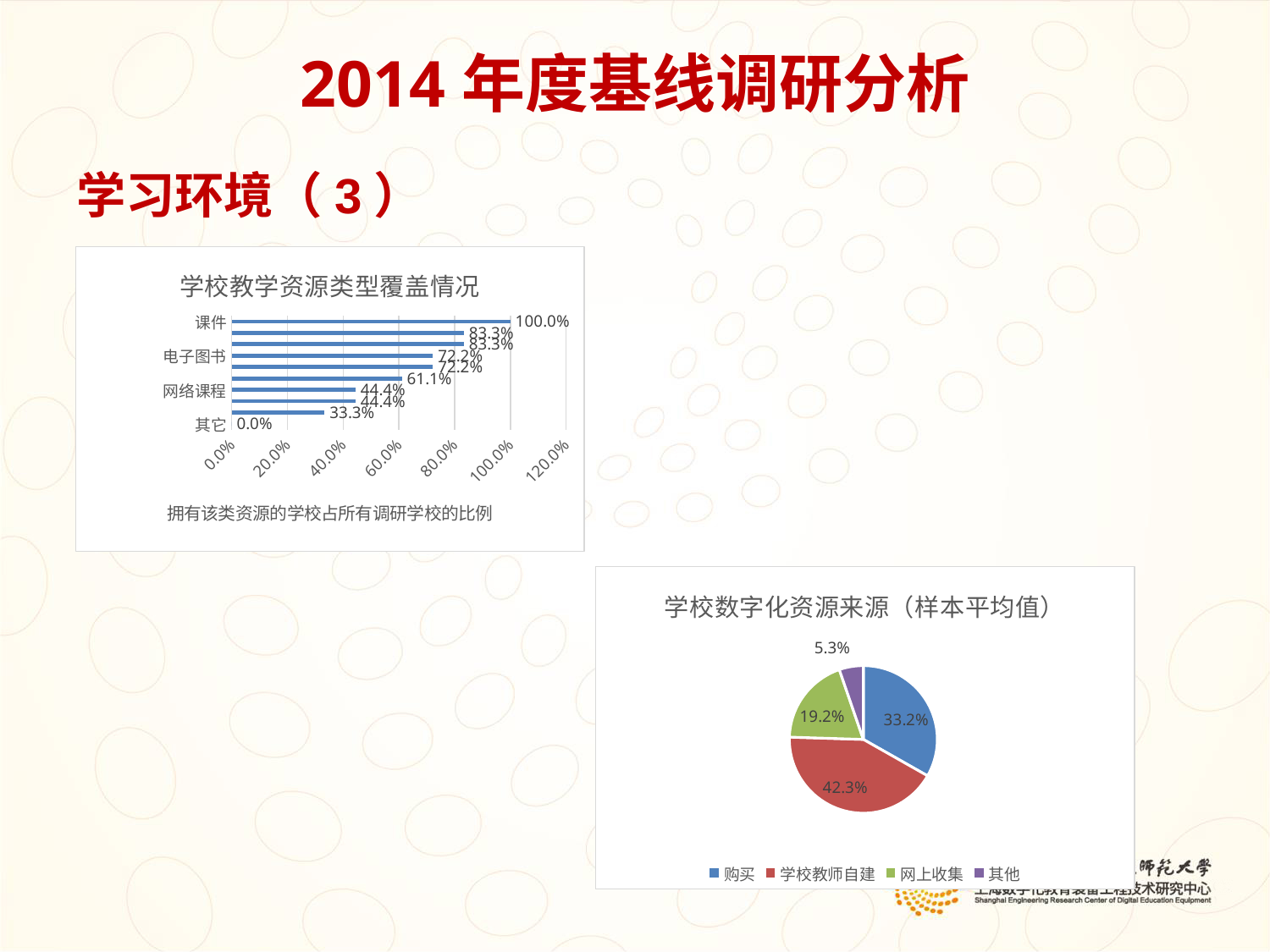
In the chart titled 学校教学资源类型覆盖情况, what is the difference between the values for 课件 and 电子图书? 27.8% In the chart titled 学校教学资源类型覆盖情况, what kind of chart is shown? Bar chart In the pie chart titled 学校数字化资源来源（样本平均值）, how many entries does the legend list? 4 In the pie chart titled 学校数字化资源来源（样本平均值）, what is the share for 学校教师自建? 42.3% In the pie chart titled 学校数字化资源来源（样本平均值）, what is the share for 购买? 33.2% In the chart titled 学校教学资源类型覆盖情况, what is the value for 其它? 0.0% In the pie chart titled 学校数字化资源来源（样本平均值）, which is larger, 网上收集 or 其他? 网上收集 In the chart titled 学校教学资源类型覆盖情况, what is the value for 电子图书? 72.2% In the chart titled 学校教学资源类型覆盖情况, which category has the highest value? 课件 In the pie chart titled 学校数字化资源来源（样本平均值）, which category has the smallest share? 其他 In the chart titled 学校教学资源类型覆盖情况, what is the value for 课件? 100.0% In the chart titled 学校教学资源类型覆盖情况, what is the value for 网络课程? 44.4%